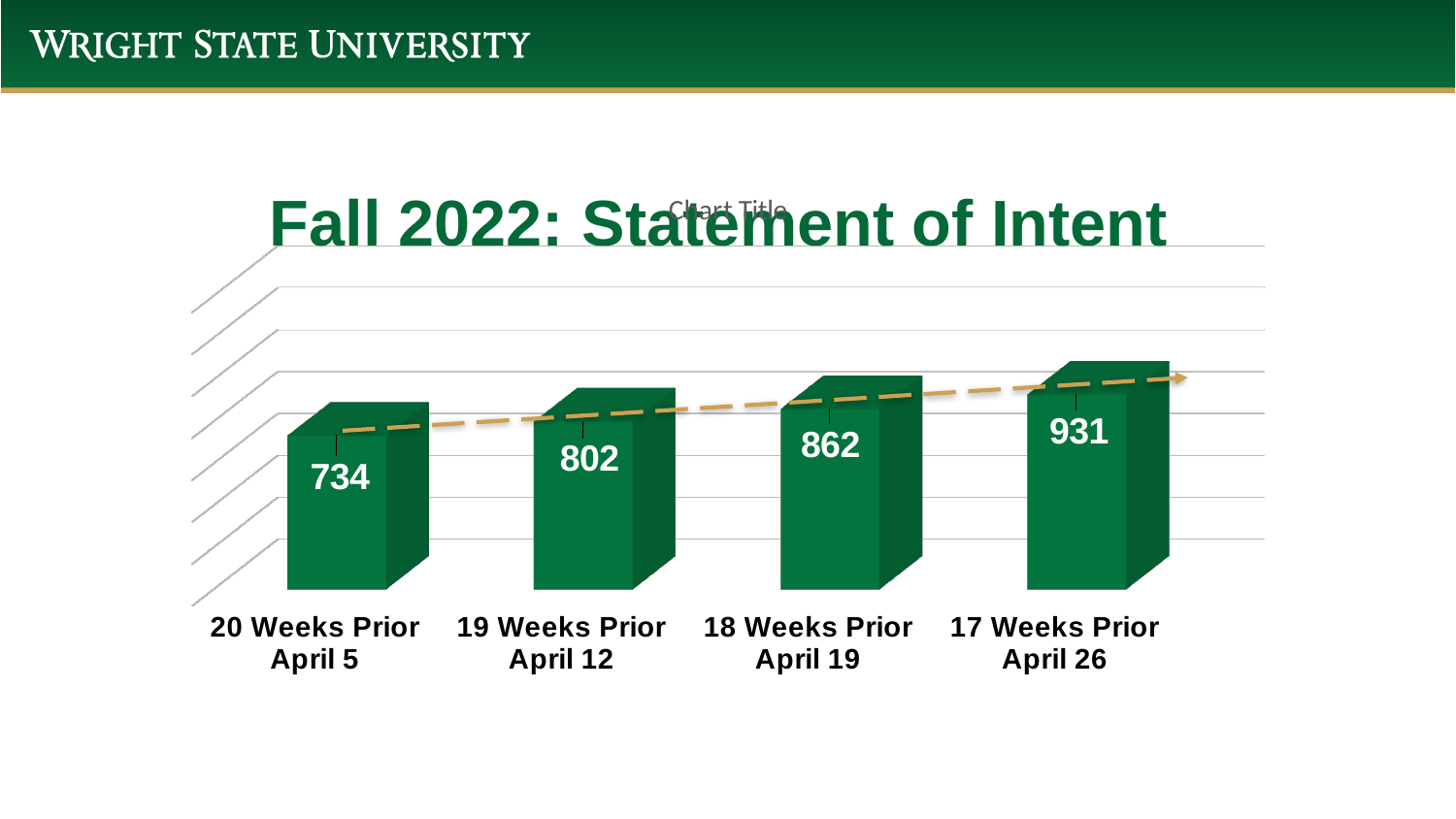
What is the value for 17 Weeks Prior (April 26)? 931 What is the value for 20 Weeks Prior (April 5)? 734 Do the values rise or fall from 20 Weeks Prior to 17 Weeks Prior? Rise What kind of chart is shown on the slide? Bar chart What is the value for 18 Weeks Prior (April 19)? 862 How many categories are shown on the chart? 4 Which category has the lowest value? 20 Weeks Prior April 5 What is the difference between the values for 17 Weeks Prior (April 26) and 20 Weeks Prior (April 5)? 197 What is the difference between the values for 19 Weeks Prior (April 12) and 18 Weeks Prior (April 19)? 60 Which category has the highest value? 17 Weeks Prior April 26 Which is larger, the value for 18 Weeks Prior (April 19) or 19 Weeks Prior (April 12)? 18 Weeks Prior April 19 What is the value for 19 Weeks Prior (April 12)? 802